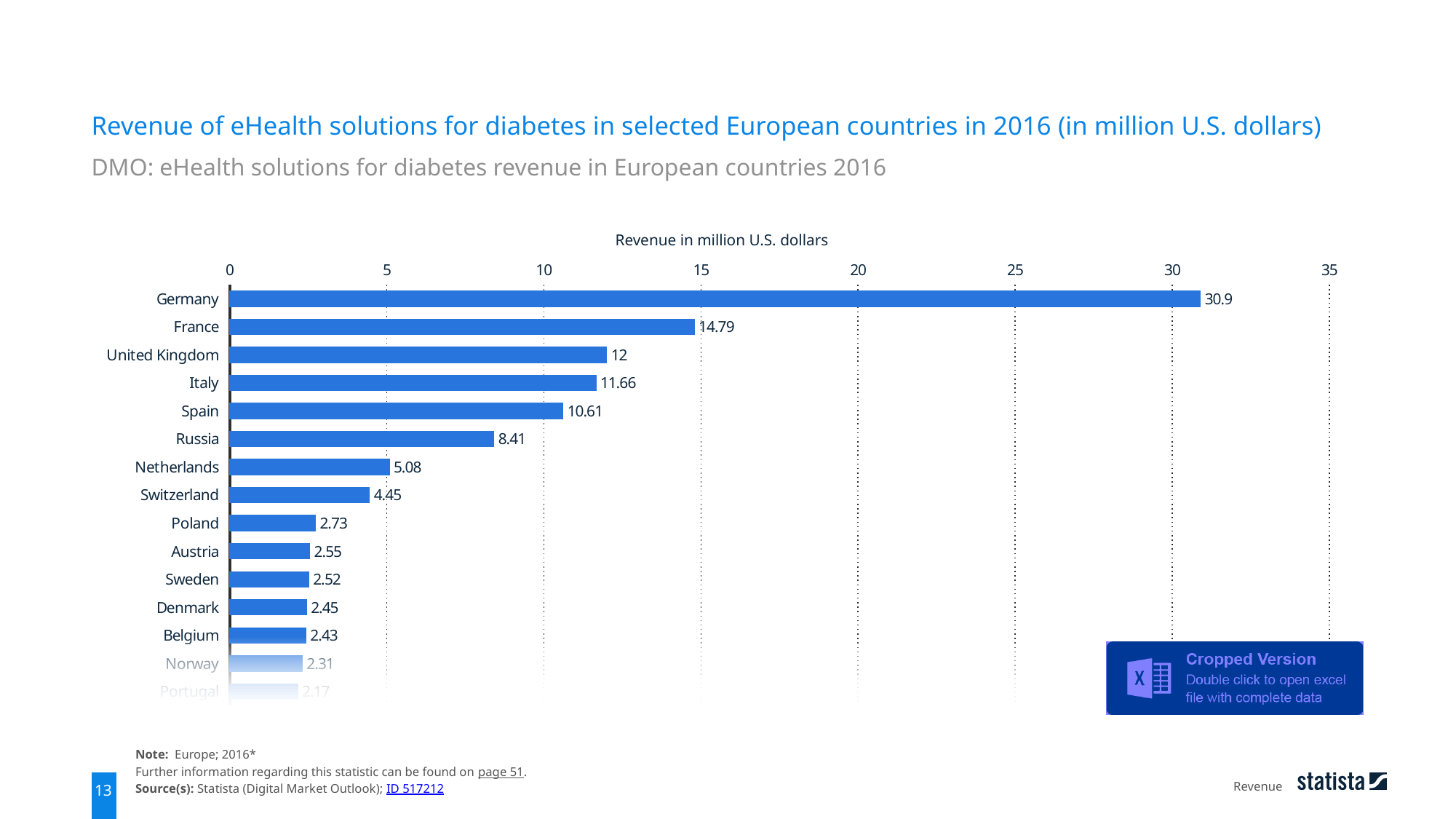
What is the revenue value shown for Poland? 2.73 Which has a larger revenue value, Russia or Switzerland? Russia What is the difference between the revenue values for Germany and France? 16.11 What is the revenue value shown for the Netherlands? 5.08 What is the revenue value shown for France? 14.79 What is the difference between the revenue values for the United Kingdom and Italy? 0.34 What is the revenue value shown for Germany? 30.9 What is the revenue value shown for Spain? 10.61 What kind of chart is shown on the slide? Bar chart What is the axis title shown above the chart? Revenue in million U.S. dollars Which country has the highest revenue in the chart? Germany Is the value for Italy greater or less than 10? greater